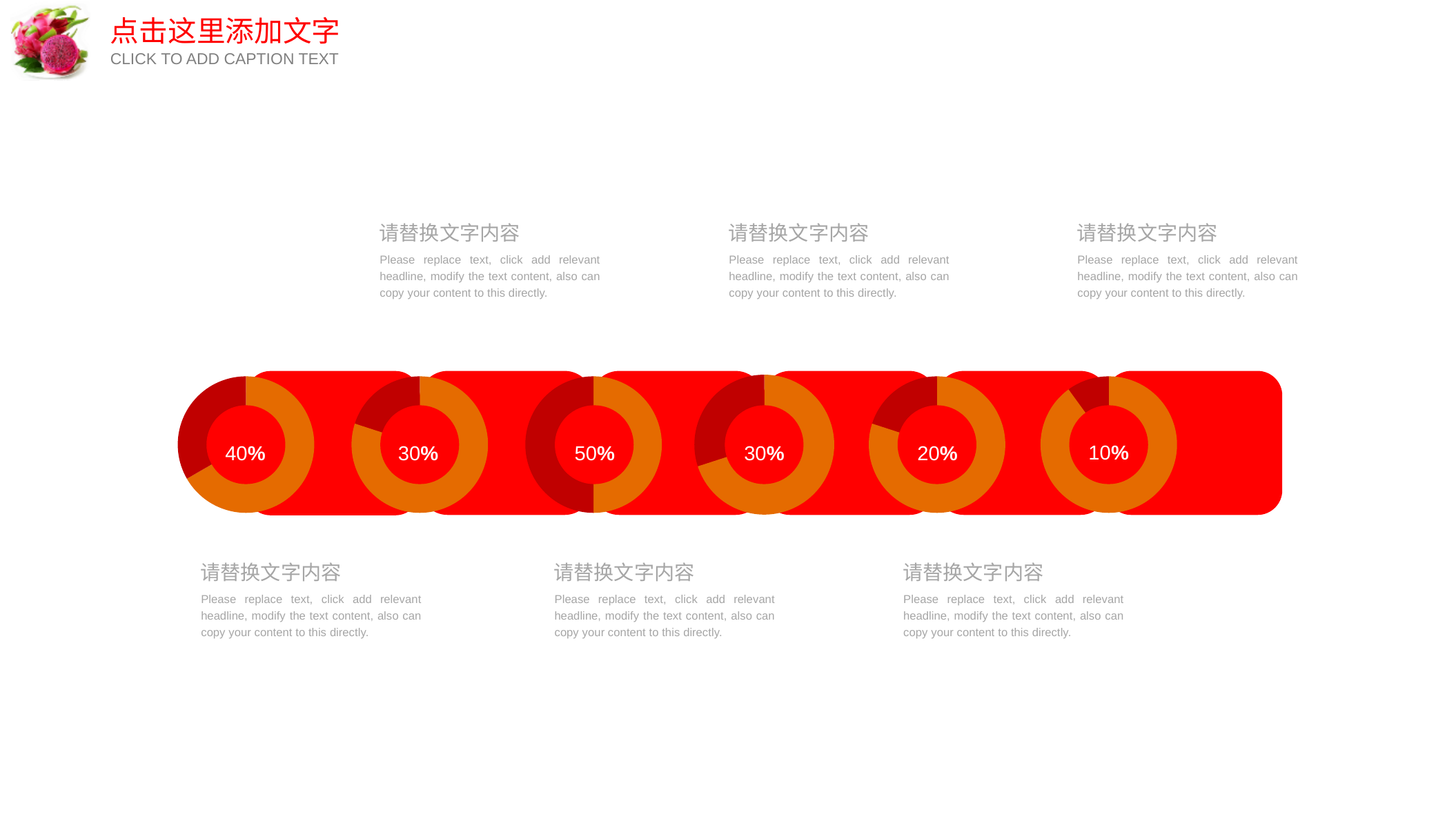
What value is shown in the centre of the sixth (rightmost) donut chart? 10% Which donut chart shows the highest percentage? The third from the left (50%) What colour is the filled (highlighted) portion of each donut ring? Dark red Which is larger, the value in the first donut chart or the value in the second donut chart? The first donut chart (40%) What value is shown in the centre of the first (leftmost) donut chart? 40% What value is shown in the centre of the fifth donut chart from the left? 20% How many donut charts are shown on the slide? 6 What kind of chart is used to display the percentages on the slide? Donut chart What value is shown in the centre of the third donut chart from the left? 50% Do the percentage values rise or fall from the fourth donut chart to the sixth donut chart? Fall What is the difference between the value in the third donut chart and the value in the rightmost donut chart? 40% Which donut chart shows the lowest percentage? The rightmost one (10%)